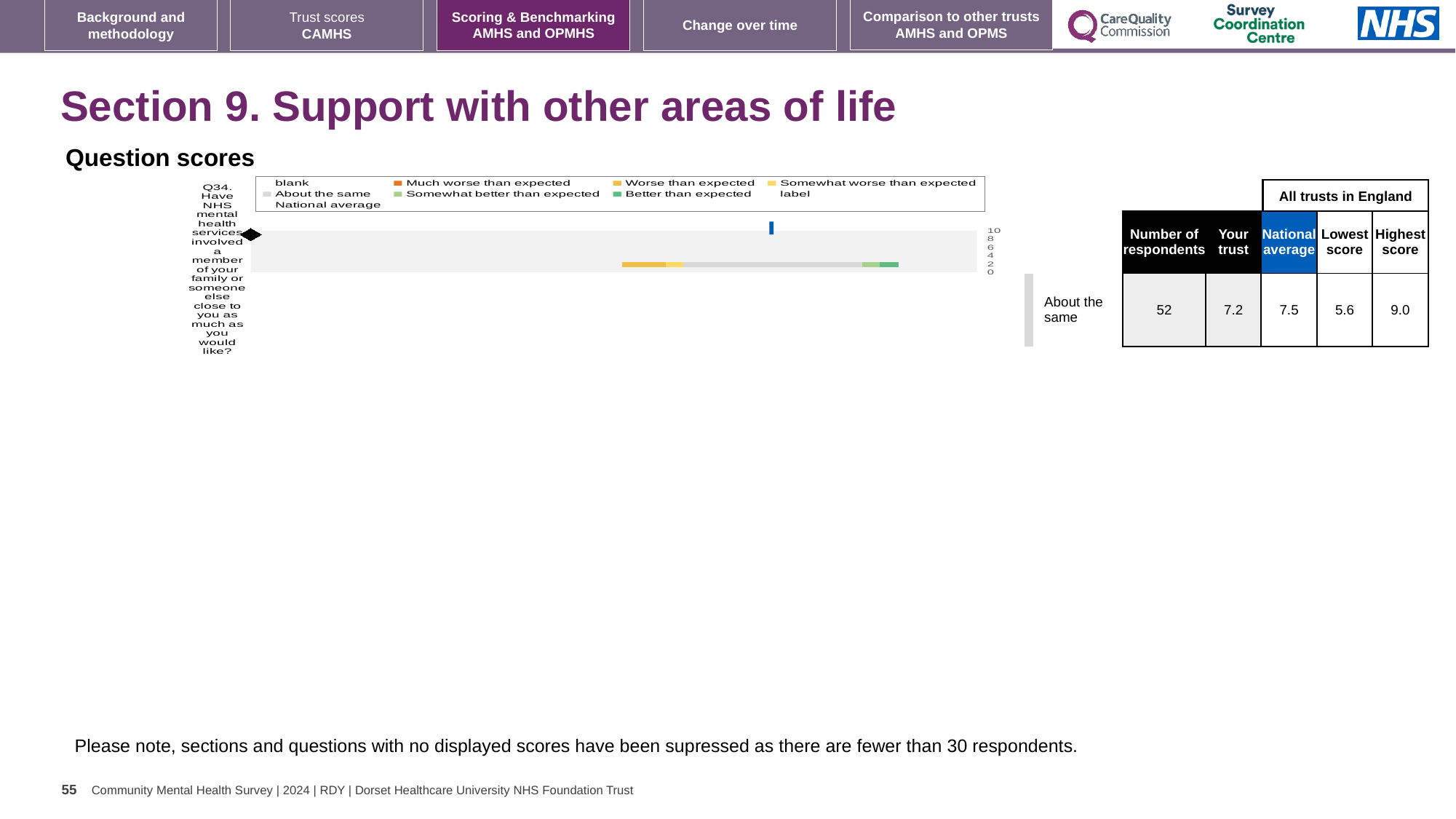
For Q34, what is the difference between the national average (7.5) and the 'Your trust' score (7.2)? 0.3 In the table beside the chart, what is the highest score among all trusts in England for Q34? 9.0 In the table beside the chart, what is the lowest score among all trusts in England for Q34? 5.6 In the table beside the chart, what is the national average score for Q34? 7.5 For Q34, what is the difference between the highest score (9.0) and the lowest score (5.6) among all trusts in England? 3.4 For Q34, which is larger: the 'Your trust' score or the national average? National average In the chart legend, which colour represents 'Much worse than expected'? orange Which question number is plotted in the Question scores chart? Q34 What kind of chart is shown under 'Question scores'? bar chart In the table beside the chart, what is the number of respondents for Q34? 52 How many questions are plotted in the Question scores chart? 1 In the table beside the chart, what is the 'Your trust' score for Q34? 7.2